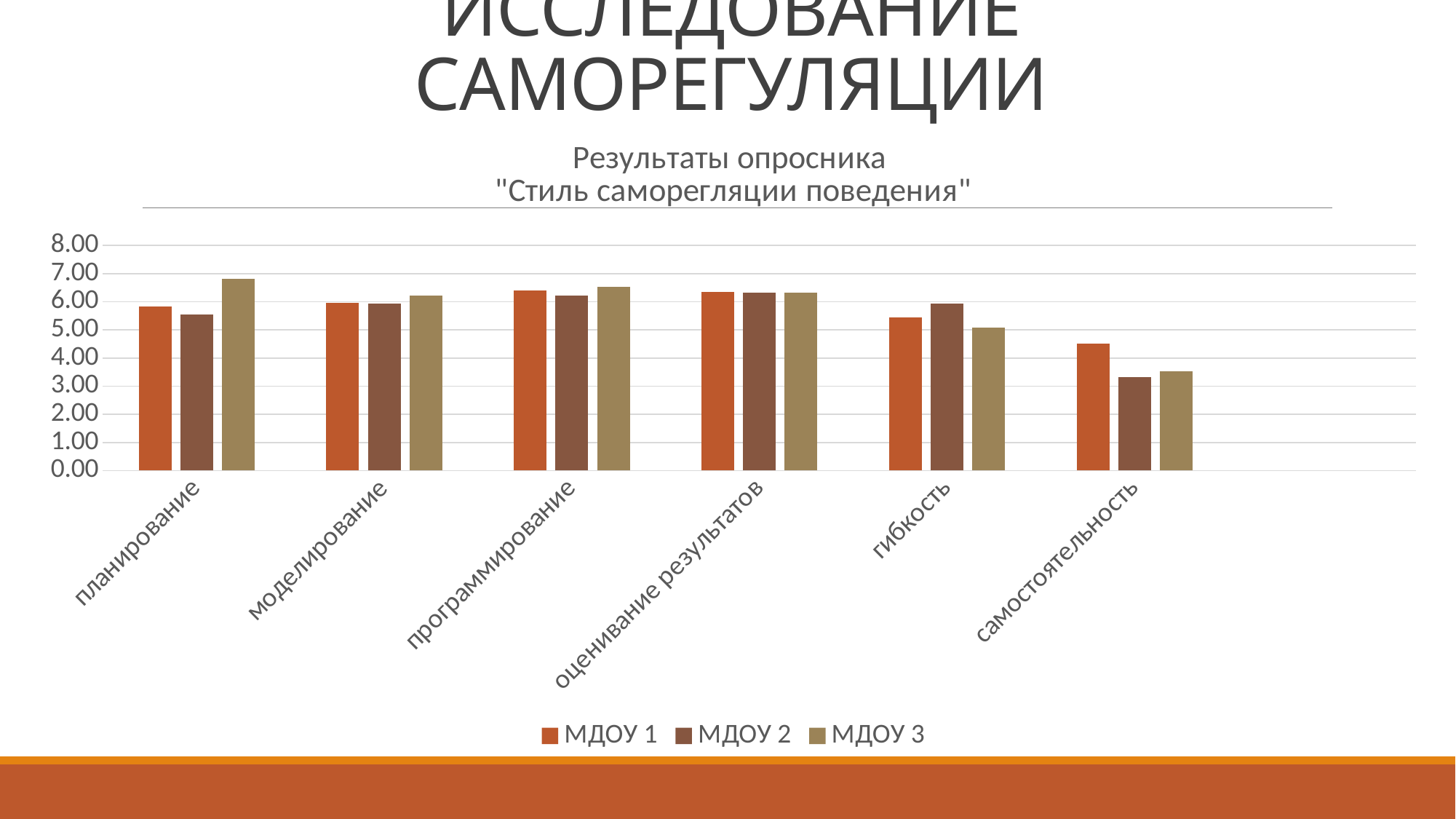
Which category has the highest value for МДОУ 3? планирование Is the value for МДОУ 3 in планирование greater or less than 6.00? greater What kind of chart is shown on the slide? Bar chart For самостоятельность, which is larger: МДОУ 1 or МДОУ 3? МДОУ 1 Which category has the lowest value for МДОУ 2? самостоятельность How many series does the legend list? 3 How many categories are shown on the x axis? 6 What is the title of the chart? Результаты опросника "Стиль саморегляции поведения" For планирование, which is larger: МДОУ 2 or МДОУ 3? МДОУ 3 Is the value for МДОУ 1 in гибкость greater or less than 6.00? less Which category has the lowest value for МДОУ 1? самостоятельность Is the value for МДОУ 1 in самостоятельность greater or less than 4.00? greater